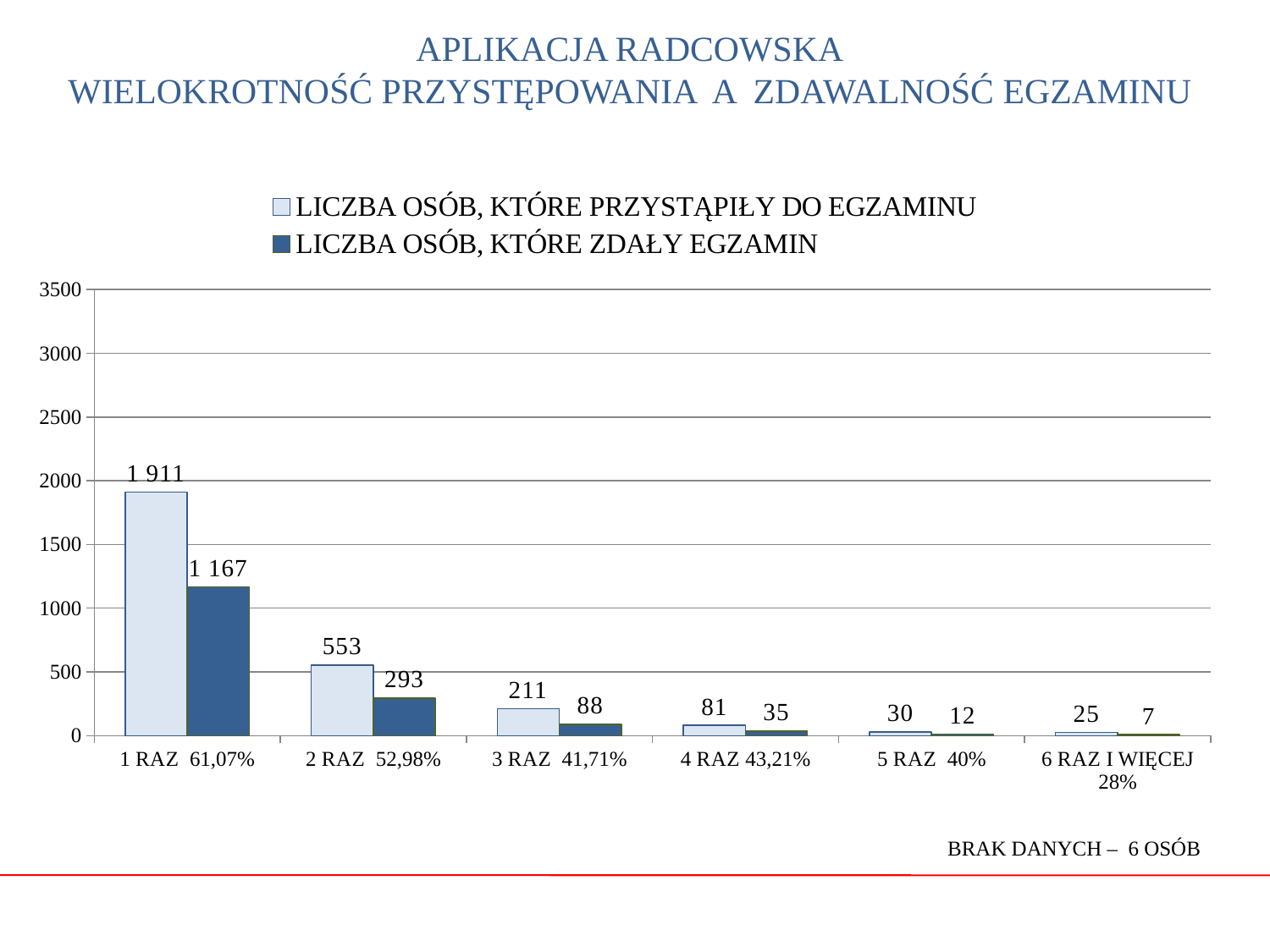
What is the difference between the number of people who attempted the exam in the 4 RAZ 43,21% category and in the 5 RAZ 40% category? 51 How many people who took the exam once (1 RAZ 61,07%) attempted the exam (LICZBA OSÓB, KTÓRE PRZYSTĄPIŁY DO EGZAMINU)? 1 911 Which is larger: the number of people who passed in the 2 RAZ 52,98% category or the number who attempted in the 3 RAZ 41,71% category? 2 RAZ 52,98% passed (293) Which category has the lowest number of people who passed the exam? 6 RAZ I WIĘCEJ 28% What kind of chart is shown on the slide? Bar chart What is the value for LICZBA OSÓB, KTÓRE ZDAŁY EGZAMIN in the 6 RAZ I WIĘCEJ 28% category? 7 How many series does the legend list? 2 How many people who took the exam twice (2 RAZ 52,98%) passed the exam (LICZBA OSÓB, KTÓRE ZDAŁY EGZAMIN)? 293 What is the difference between the number of people who attempted and the number who passed in the 1 RAZ 61,07% category? 744 Which category has the highest number of people who attempted the exam? 1 RAZ 61,07% What is the value for LICZBA OSÓB, KTÓRE PRZYSTĄPIŁY DO EGZAMINU in the 3 RAZ 41,71% category? 211 How many categories are shown on the x axis? 6